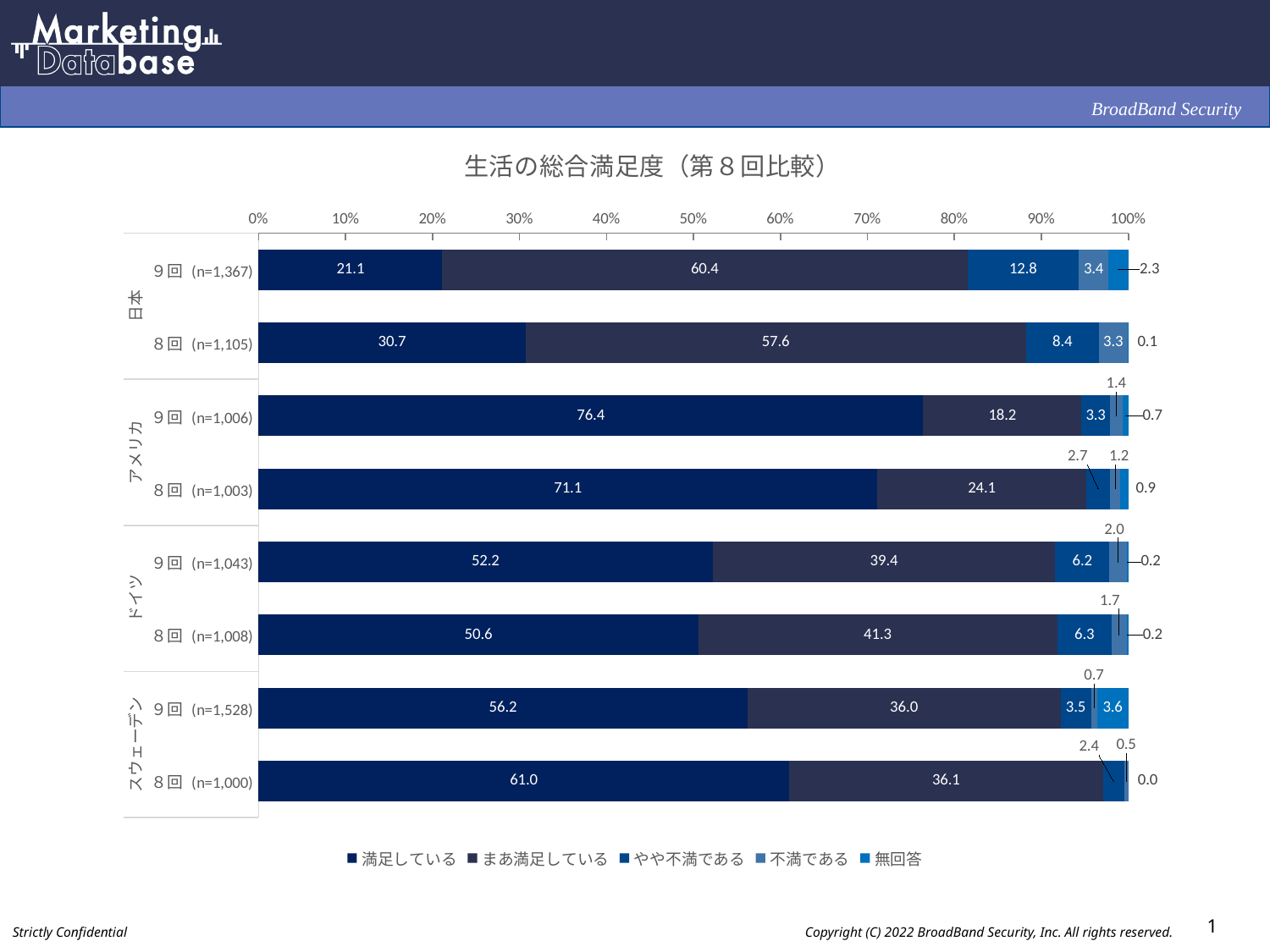
Is the 満足している value for スウェーデン 8回 (n=1,000) greater or less than 50%? greater Which row has the lowest 満足している value? 日本 9回 (n=1,367) What type of chart is shown on the slide? Stacked bar chart What is the まあ満足している value for アメリカ 8回 (n=1,003)? 24.1 Which row has the highest 満足している value? アメリカ 9回 (n=1,006) How many series does the legend list? 5 What is the 無回答 value for スウェーデン 9回 (n=1,528)? 3.6 What is the 満足している value for 日本 9回 (n=1,367)? 21.1 What is the difference between the 満足している values for 日本 8回 (n=1,105) and 日本 9回 (n=1,367)? 9.6 How many bars (country/survey-round rows) are plotted in the chart? 8 Which is larger, the やや不満である value for 日本 9回 (n=1,367) or for ドイツ 9回 (n=1,043)? 日本 9回 (n=1,367) What is the title of the chart? 生活の総合満足度（第8回比較）